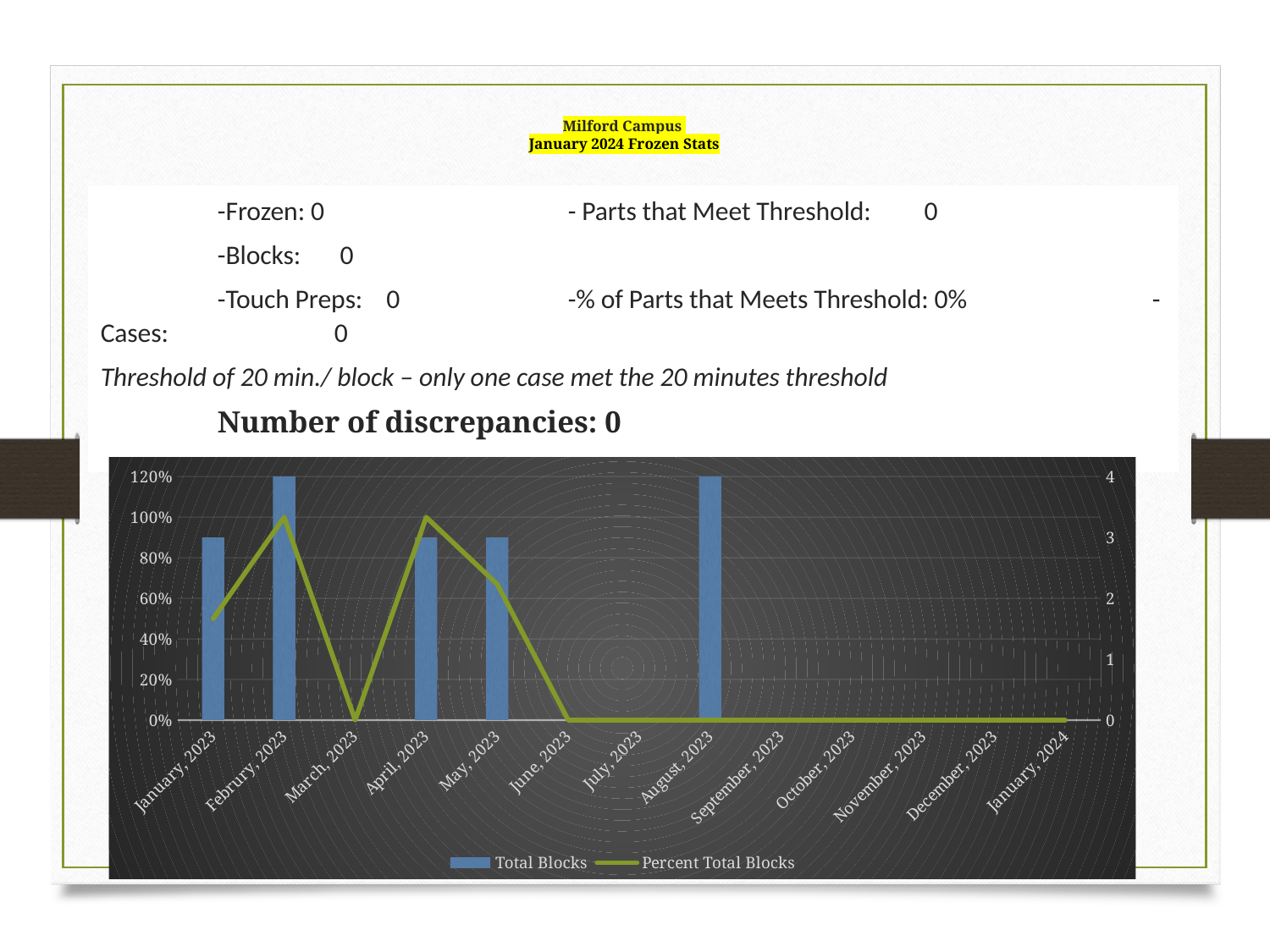
What is the Total Blocks value for August, 2023? 4 What is the Total Blocks value for January, 2023? 3 Is the Percent Total Blocks value for January, 2023 greater or less than 80%? less What is the Percent Total Blocks value for April, 2023? 100% What kind of chart is shown on the slide? A combination bar and line chart How many series does the chart legend list? 2 Does the Percent Total Blocks line rise or fall from May, 2023 to June, 2023? fall Which has the larger Total Blocks value, January, 2023 or February, 2023? February, 2023 How many months are shown along the x axis of the chart? 13 What is the Total Blocks value for December, 2023? 0